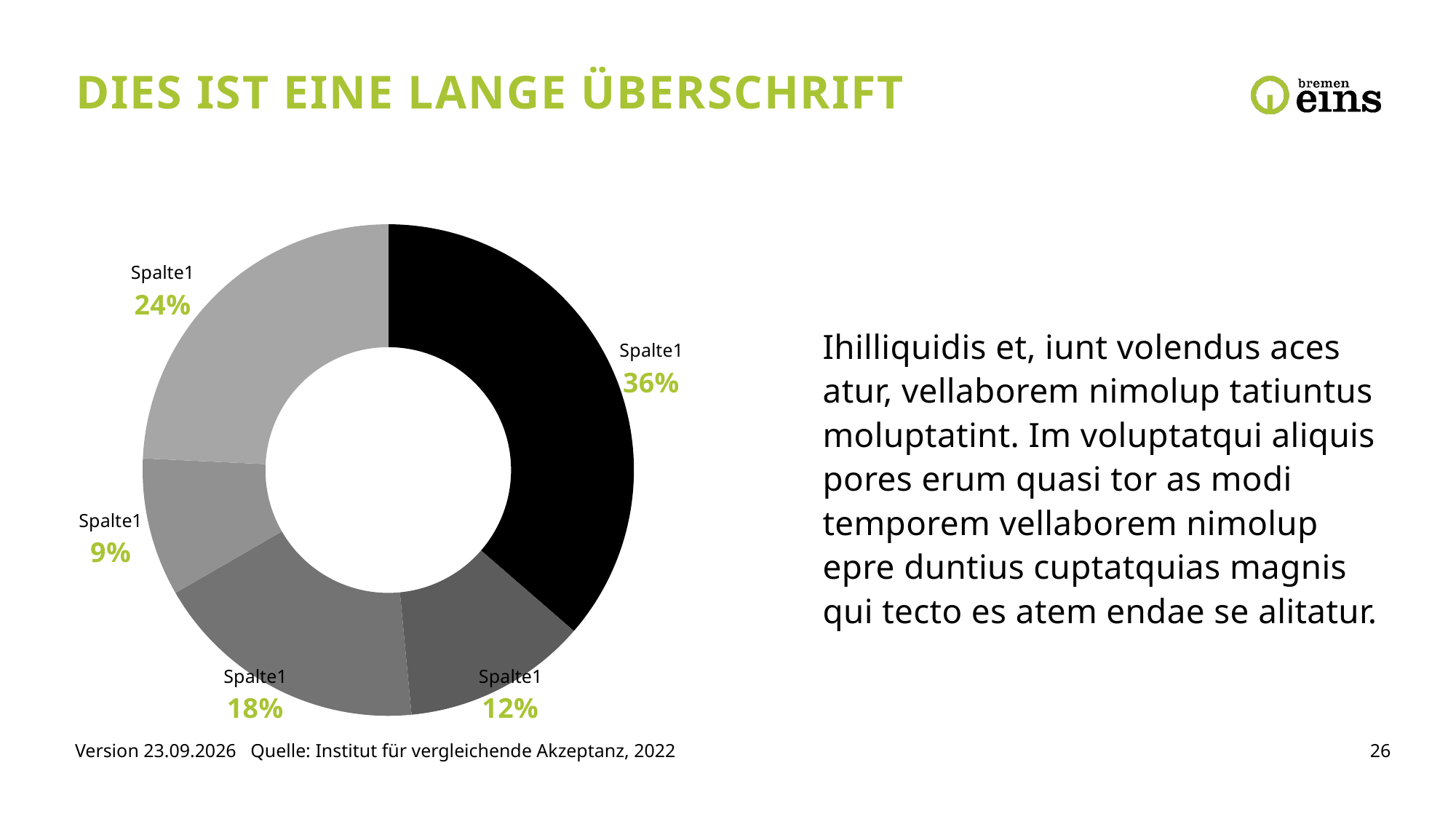
How many slices does the doughnut chart have? 5 What percentage is shown for the light grey slice at the top left of the doughnut chart? 24% What kind of chart is shown on the slide? Doughnut (ring) pie chart What percentage is shown for the slice at the bottom left of the doughnut chart? 18% What is the largest percentage shown on the doughnut chart? 36% What colour is the largest slice of the doughnut chart? Black Which slice is larger: the black slice on the right or the light grey slice at the top left? The black slice (36%) What is the difference in percentage points between the largest slice (36%) and the light grey slice (24%)? 12 percentage points What percentage is shown for the black slice on the right of the doughnut chart? 36% What is the smallest percentage shown on the doughnut chart? 9% What percentage is shown for the dark grey slice at the bottom right of the doughnut chart? 12% What label is shown for every slice of the doughnut chart? Spalte1